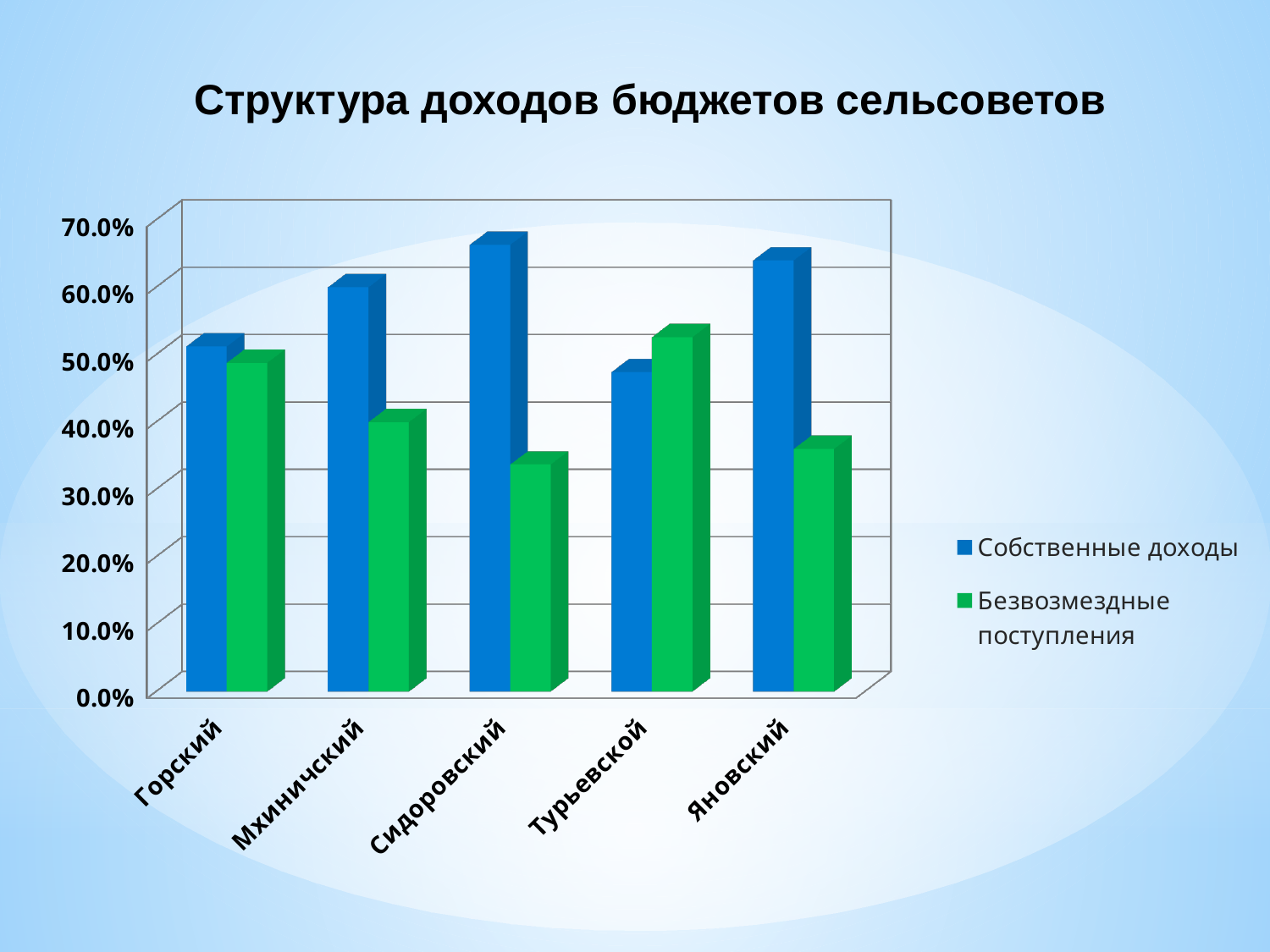
What is the title of the chart? Структура доходов бюджетов сельсоветов Which category has the lowest value for Собственные доходы? Турьевской Which colour represents Безвозмездные поступления in the chart? Green Which category has the lowest value for Безвозмездные поступления? Сидоровский Which category has the highest value for Безвозмездные поступления? Турьевской Is the value of Безвозмездные поступления for Мхиничский greater or less than 50.0%? less How many series does the legend list? 2 What kind of chart is shown on the slide? Bar chart For Турьевской, which is larger: Собственные доходы or Безвозмездные поступления? Безвозмездные поступления How many village councils (categories) are shown on the x axis? 5 Which category has the highest value for Собственные доходы? Сидоровский Is the value of Собственные доходы for Сидоровский greater or less than 60.0%? greater